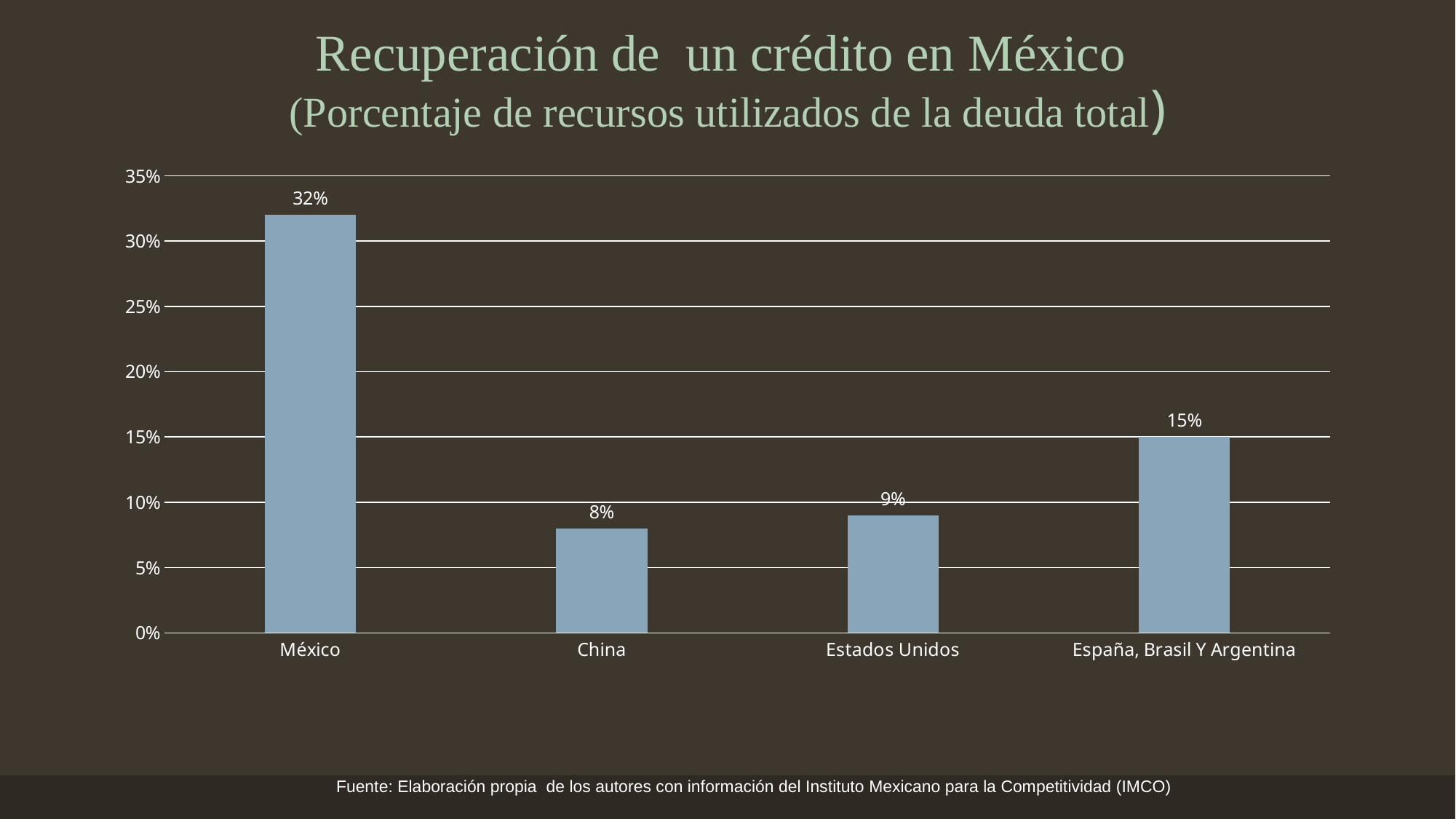
Which category has the lowest value? China What is the value for Estados Unidos? 9% What is the difference between the values for México and España, Brasil Y Argentina? 17% What is the title of the chart? Recuperación de un crédito en México (Porcentaje de recursos utilizados de la deuda total) Which is larger, the value for Estados Unidos or the value for España, Brasil Y Argentina? España, Brasil Y Argentina What is the value for China? 8% What is the value for México? 32% How many categories are shown on the x axis? 4 Which category has the highest value? México Is the value for México greater or less than 30%? greater What is the value for España, Brasil Y Argentina? 15% What kind of chart is shown on the slide? bar chart